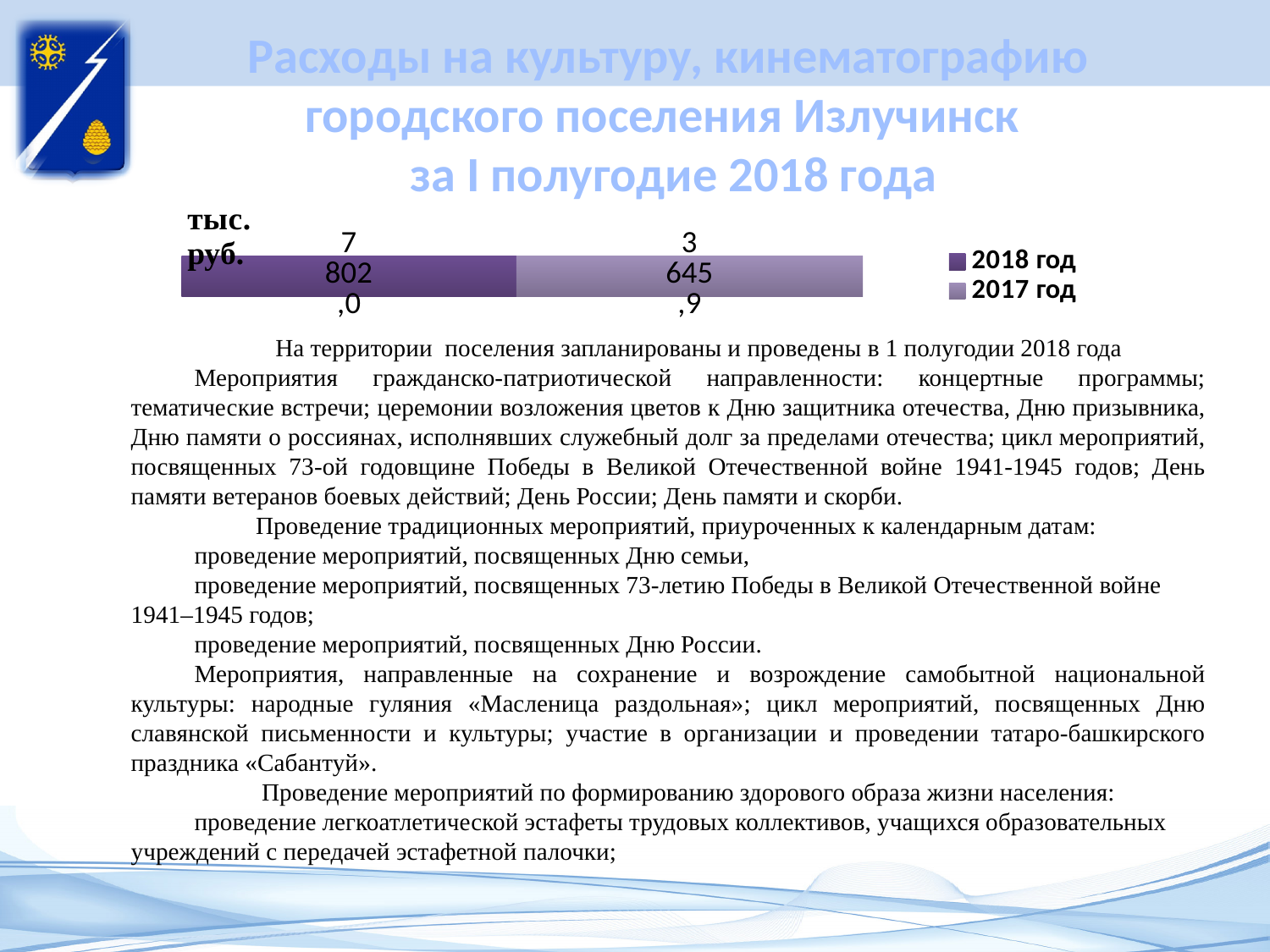
What is the value for 2018 год on the chart? 7 802,0 What is the value for 2017 год on the chart? 3 645,9 What is the total of the two segments of the stacked bar? 11 447,9 What unit is indicated for the values on the chart? тыс. руб. Which series has the smallest value on the chart? 2017 год How many series does the legend list? 2 What kind of chart is shown on the slide? bar chart Which legend entry is shown in the darker purple colour? 2018 год What is the difference between the values for 2018 год and 2017 год? 4 156,1 Which year has the higher value on the chart, 2018 год or 2017 год? 2018 год Which series has the largest value on the chart? 2018 год